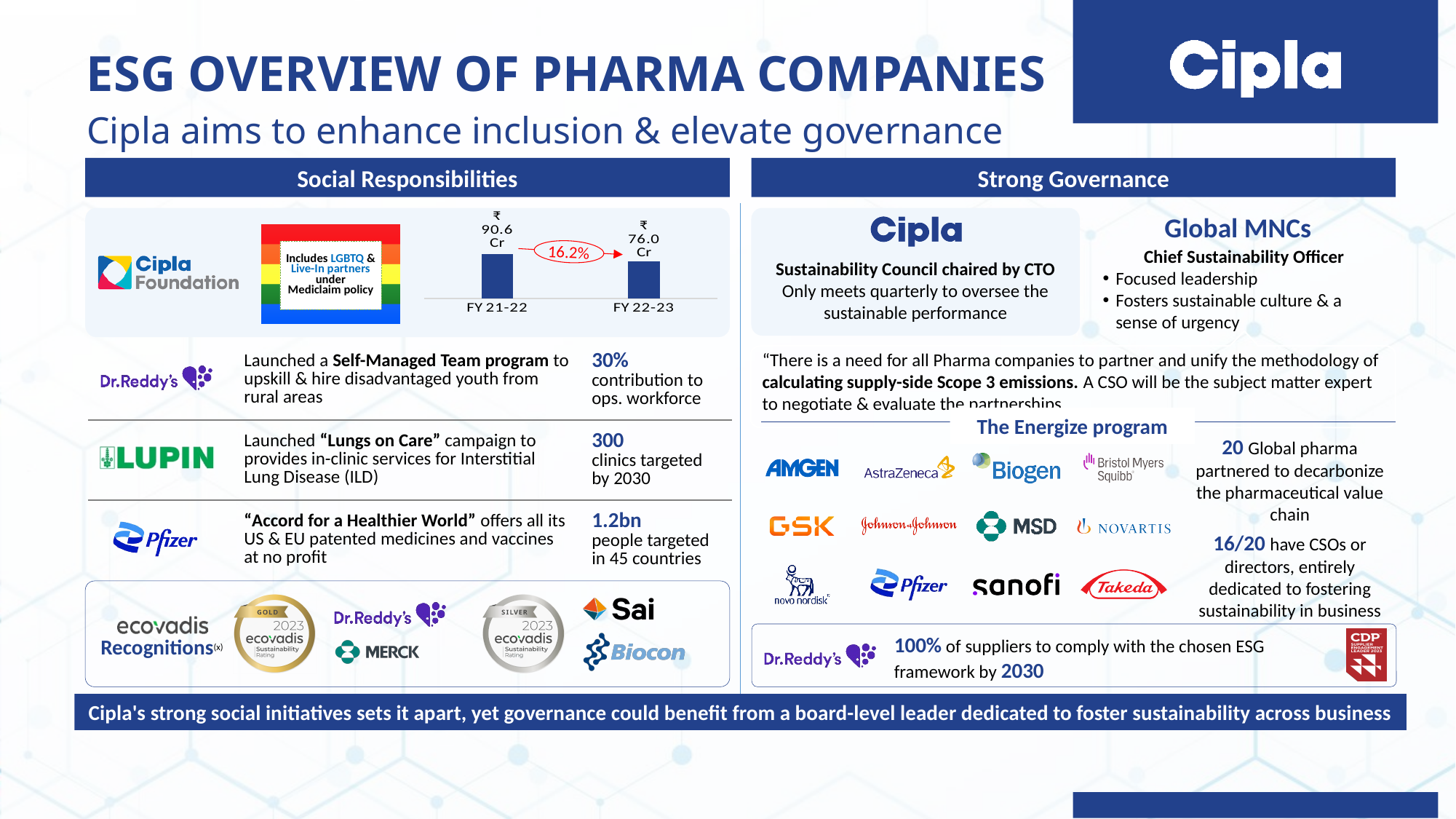
What is the difference in Cr between the FY 21-22 and FY 22-23 bars? 14.6 Cr What currency symbol is used for the values in the bar chart? ₹ What value is shown for FY 21-22 in the bar chart? ₹ 90.6 Cr Which fiscal year has the lower bar in the chart? FY 22-23 What percentage change is annotated between the two bars in the chart? 16.2% Do the values rise or fall from FY 21-22 to FY 22-23? fall Which fiscal year has the higher bar in the chart? FY 21-22 What kind of chart is shown in the Social Responsibilities section? bar chart How many bars are plotted in the chart? 2 What value is shown for FY 22-23 in the bar chart? ₹ 76.0 Cr Is the value for FY 22-23 larger or smaller than the value for FY 21-22? smaller